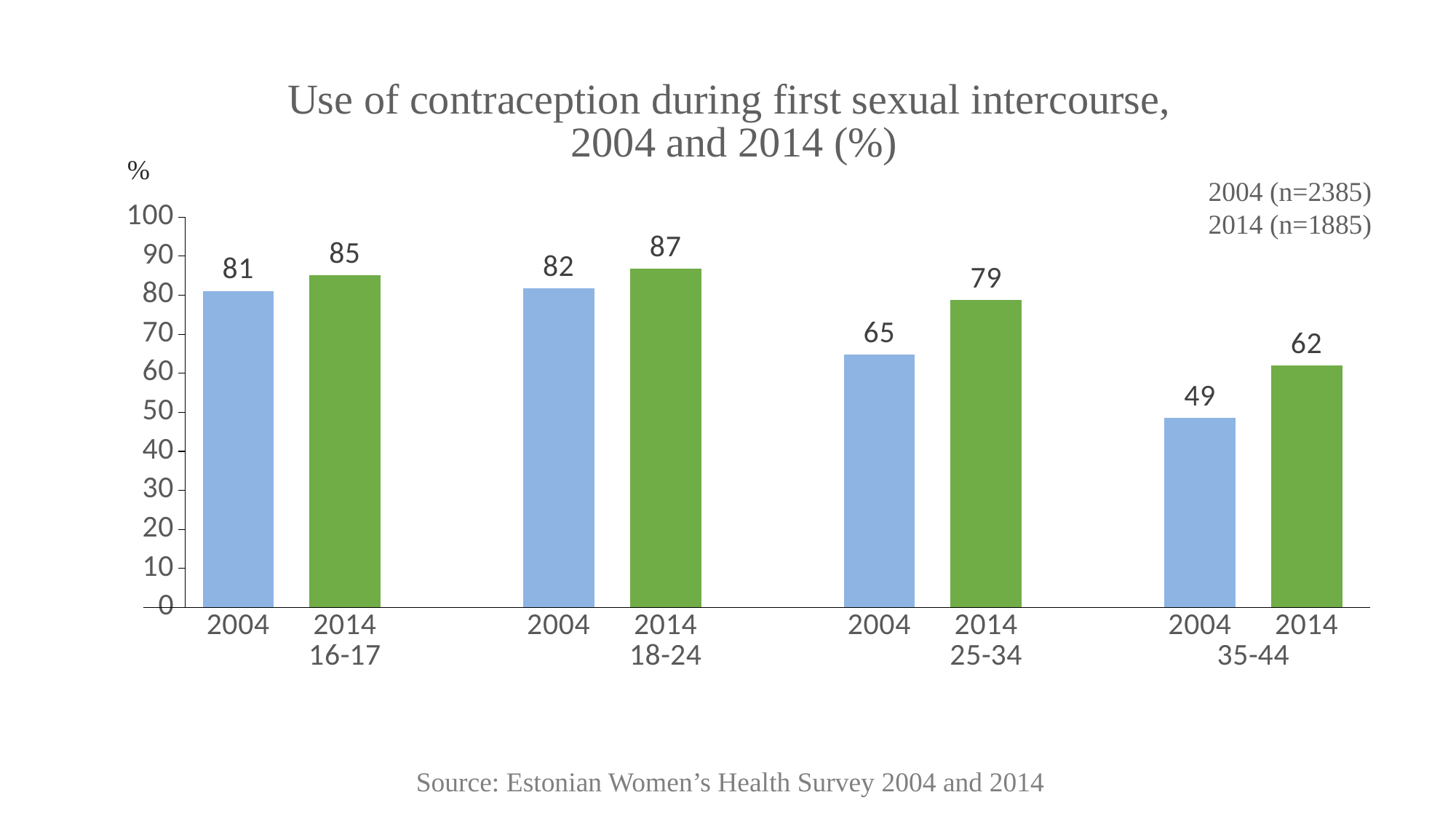
Which bar has the highest value on the chart? 2014, 18-24 What is the value for 2014 in the 18-24 age group? 87 What is the difference between the 2014 and 2004 values in the 25-34 age group? 14 What is the value for 2004 in the 35-44 age group? 49 How many age groups are shown on the chart? 4 What is the difference between the 2014 and 2004 values in the 35-44 age group? 13 Which is larger, the 2004 value for 16-17 or the 2004 value for 18-24? 2004 value for 18-24 Is the value for 2014 in the 35-44 age group greater or less than 70? less What is the sample size (n) for 2014 shown on the slide? 1885 What is the value for 2004 in the 25-34 age group? 65 Which bar has the lowest value on the chart? 2004, 35-44 What kind of chart is shown on the slide? bar chart